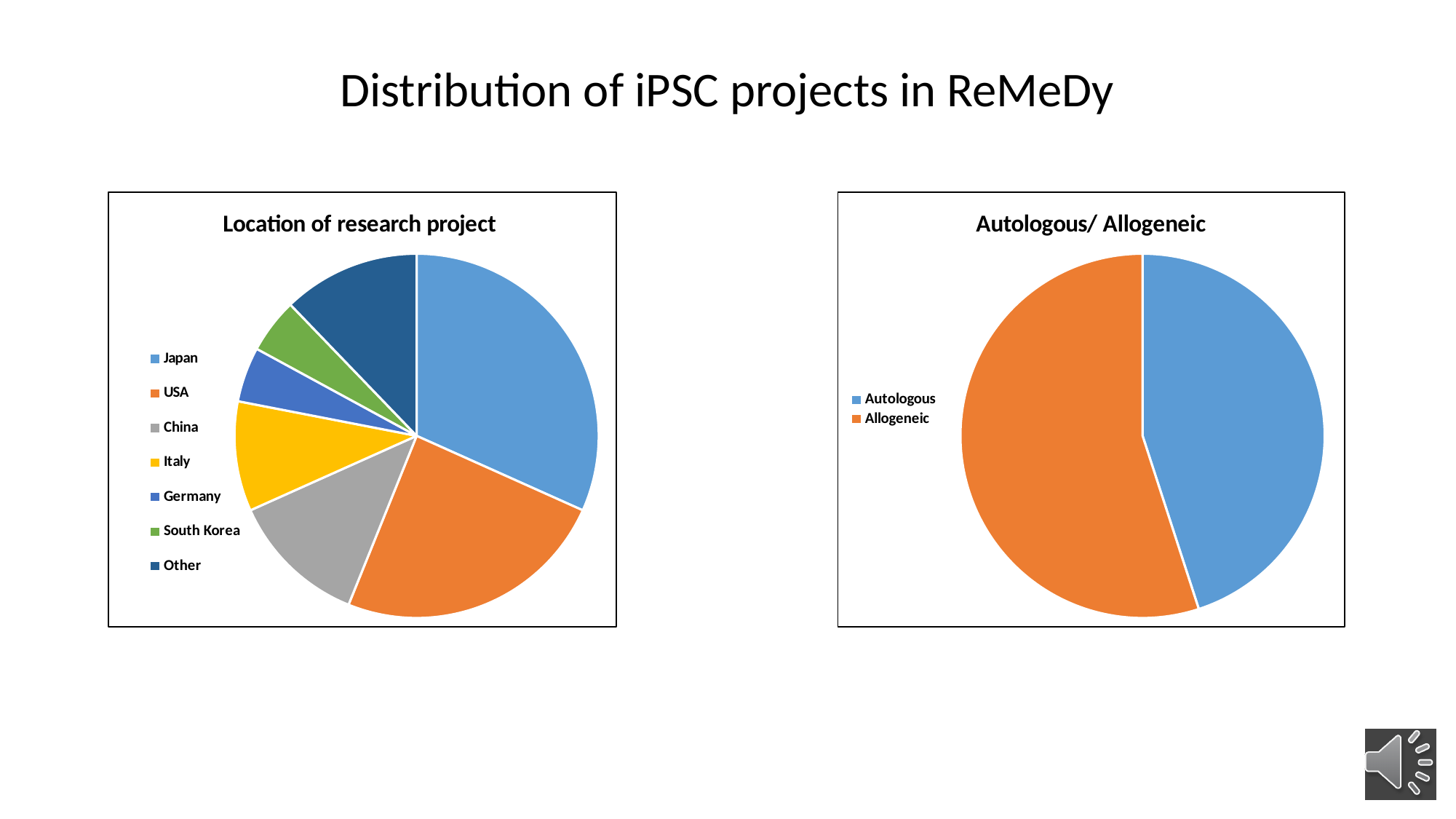
In the 'Location of research project' chart, which slice is larger, Japan or USA? Japan What is the title of the slide? Distribution of iPSC projects in ReMeDy In the 'Autologous/ Allogeneic' chart, how many slices does the pie have? 2 In the 'Location of research project' chart, which location has the largest slice? Japan In the 'Location of research project' chart, which slice is larger, Other or South Korea? Other In the 'Autologous/ Allogeneic' chart, which category has the larger slice? Allogeneic In the 'Location of research project' chart, which slice is larger, China or Germany? China What kind of chart is the 'Autologous/ Allogeneic' chart? pie chart In the 'Location of research project' chart, how many categories does the legend list? 7 What kind of chart is the 'Location of research project' chart? pie chart In the 'Location of research project' chart, which colour represents Italy? yellow In the 'Autologous/ Allogeneic' chart, which slice is smaller, Autologous or Allogeneic? Autologous